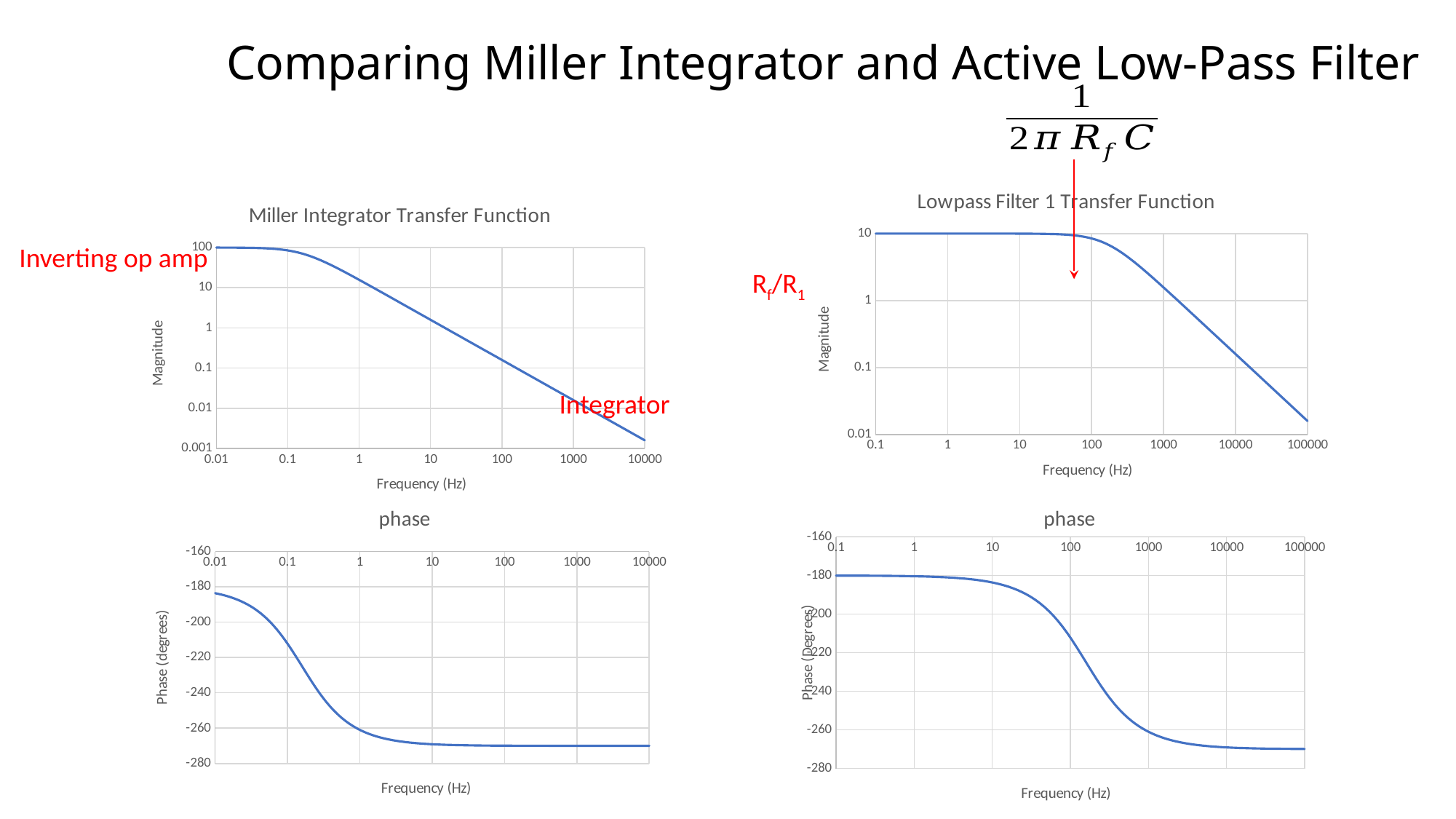
In the 'Miller Integrator Transfer Function' chart, does the magnitude rise or fall as frequency increases? fall In the 'Lowpass Filter 1 Transfer Function' chart, is the magnitude at 100000 Hz greater or less than 0.1? less In the bottom-left 'phase' chart, is the phase at 10000 Hz greater or less than -260? less How many charts are shown on the slide? 4 What kind of chart is the 'Miller Integrator Transfer Function' chart? line chart In the bottom-right 'phase' chart, does the phase rise or fall as frequency increases? fall In the 'Lowpass Filter 1 Transfer Function' chart, does the magnitude rise or fall between 1000 Hz and 100000 Hz? fall In the 'Miller Integrator Transfer Function' chart, is the magnitude at 10000 Hz greater or less than 0.01? less What is the x-axis label of the 'Lowpass Filter 1 Transfer Function' chart? Frequency (Hz)